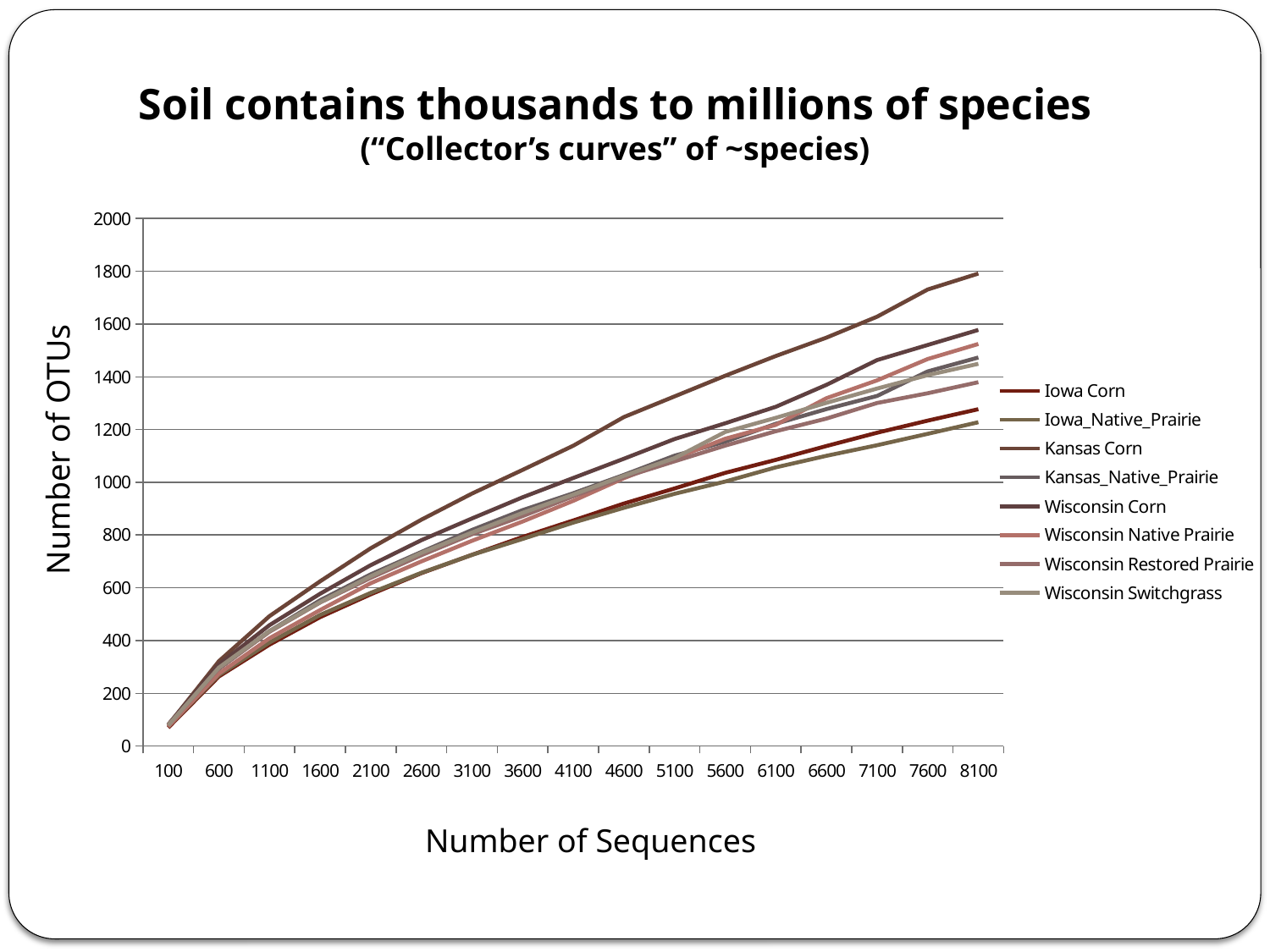
At 8100 sequences, which is larger: the value for Kansas Corn or the value for Iowa Corn? Kansas Corn What is the label of the x axis? Number of Sequences Is the value for Kansas Corn at 8100 sequences greater or less than 1600? greater Is the value for Wisconsin Corn at 8100 sequences greater or less than 1400? greater Do the values for Kansas Corn rise or fall as the number of sequences increases? rise Which series has the highest number of OTUs at 8100 sequences? Kansas Corn Is the value for Iowa Corn at 8100 sequences greater or less than 1400? less How many series does the legend list? 8 What is the label of the y axis? Number of OTUs How many x-axis tick values (number of sequences) are shown on the chart? 17 What kind of chart is shown on the slide? line chart